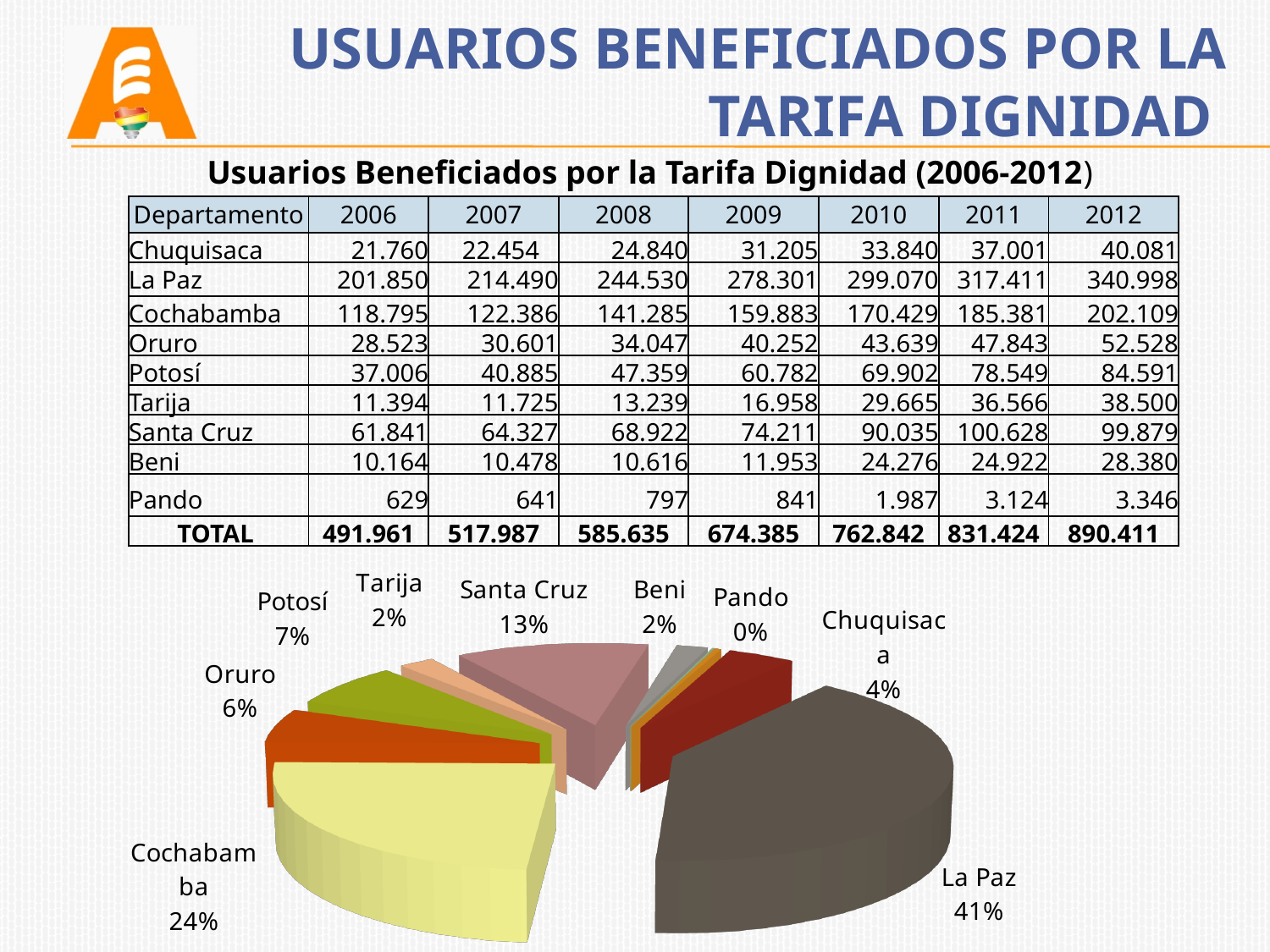
In the pie chart, what share is labelled for Santa Cruz? 13% How many slices does the pie chart have? 9 Which department has the largest slice in the pie chart? La Paz In the pie chart, what is the difference in percentage points between the Santa Cruz share and the Potosí share? 6 In the pie chart, what is the difference in percentage points between the La Paz share and the Cochabamba share? 17 In the pie chart, what share is labelled for Potosí? 7% What type of chart is shown at the bottom of the slide? pie chart In the pie chart, which is larger: the share for Oruro or the share for Chuquisaca? Oruro In the pie chart, what share is labelled for La Paz? 41% Which department has the smallest slice in the pie chart? Pando In the pie chart, what share is labelled for Pando? 0% In the pie chart, what share is labelled for Cochabamba? 24%